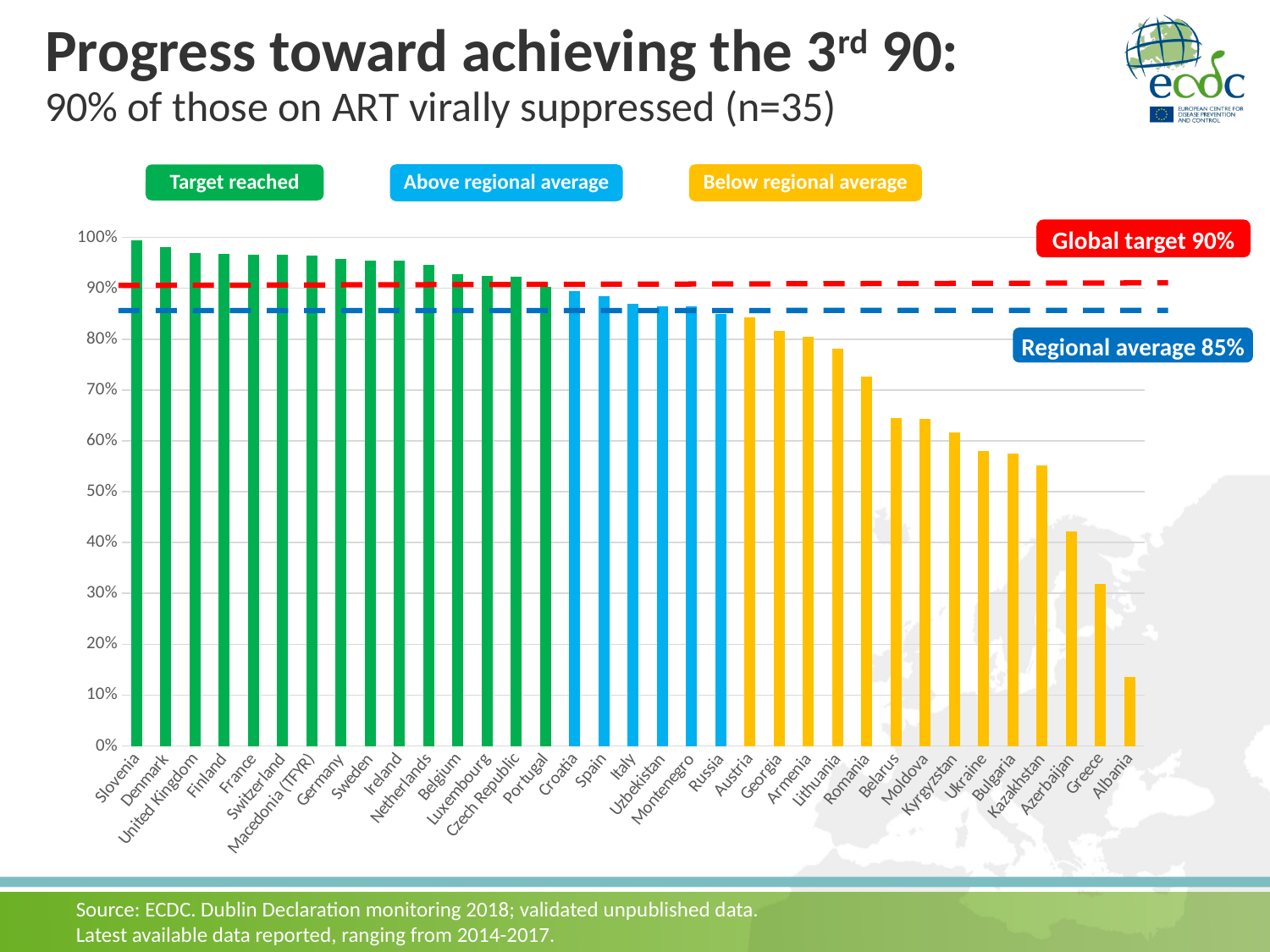
Which country has the lowest value in the chart? Albania What kind of chart is shown on the slide? bar chart Do the bar values rise or fall moving from left to right along the x axis? fall How many countries are plotted in the chart? 35 Which country has the highest value in the chart? Slovenia Which has a larger value, Romania or Belarus? Romania Is the value for Romania greater or less than 70%? greater What value does the blue dashed line labelled 'Regional average' represent? 85% How many categories does the legend above the chart list? 3 What value does the red dashed line labelled 'Global target' represent? 90% Is the value for Greece greater or less than 40%? less Is the value for Kazakhstan greater or less than 60%? less